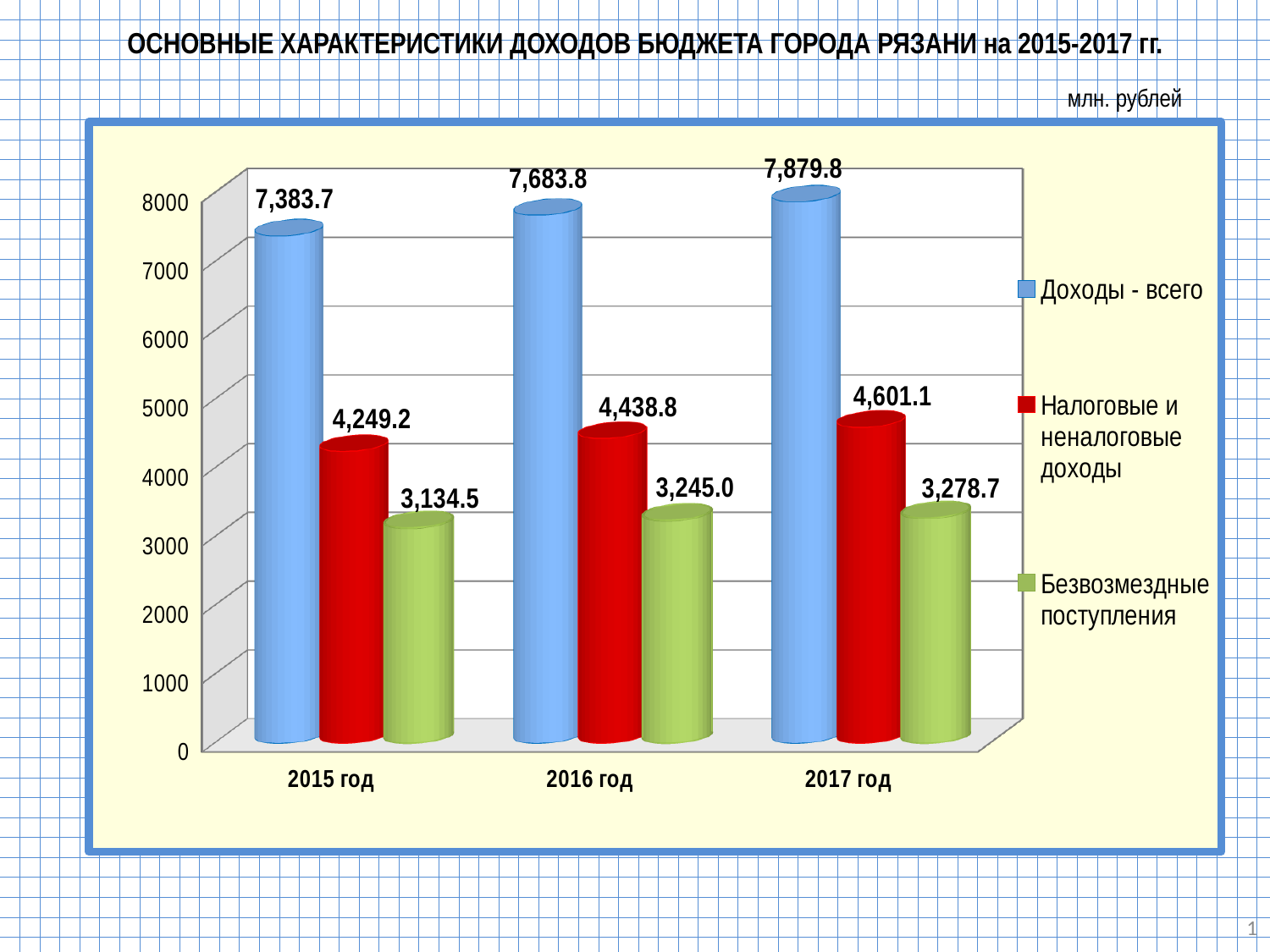
What kind of chart is shown on the slide? Bar chart In which year is "Безвозмездные поступления" the lowest? 2015 год How many years are shown on the x axis? 3 Do the values of "Доходы - всего" rise or fall from 2015 год to 2017 год? Rise What is the value of "Доходы - всего" for 2015 год? 7,383.7 How many series does the legend list? 3 What is the value of "Налоговые и неналоговые доходы" for 2016 год? 4,438.8 Which is larger: "Налоговые и неналоговые доходы" in 2016 год or "Безвозмездные поступления" in 2016 год? Налоговые и неналоговые доходы What is the value of "Безвозмездные поступления" for 2017 год? 3,278.7 What is the difference between "Доходы - всего" in 2017 год and in 2015 год? 496.1 What is the difference between "Налоговые и неналоговые доходы" in 2017 год and in 2015 год? 351.9 In which year is "Доходы - всего" the highest? 2017 год